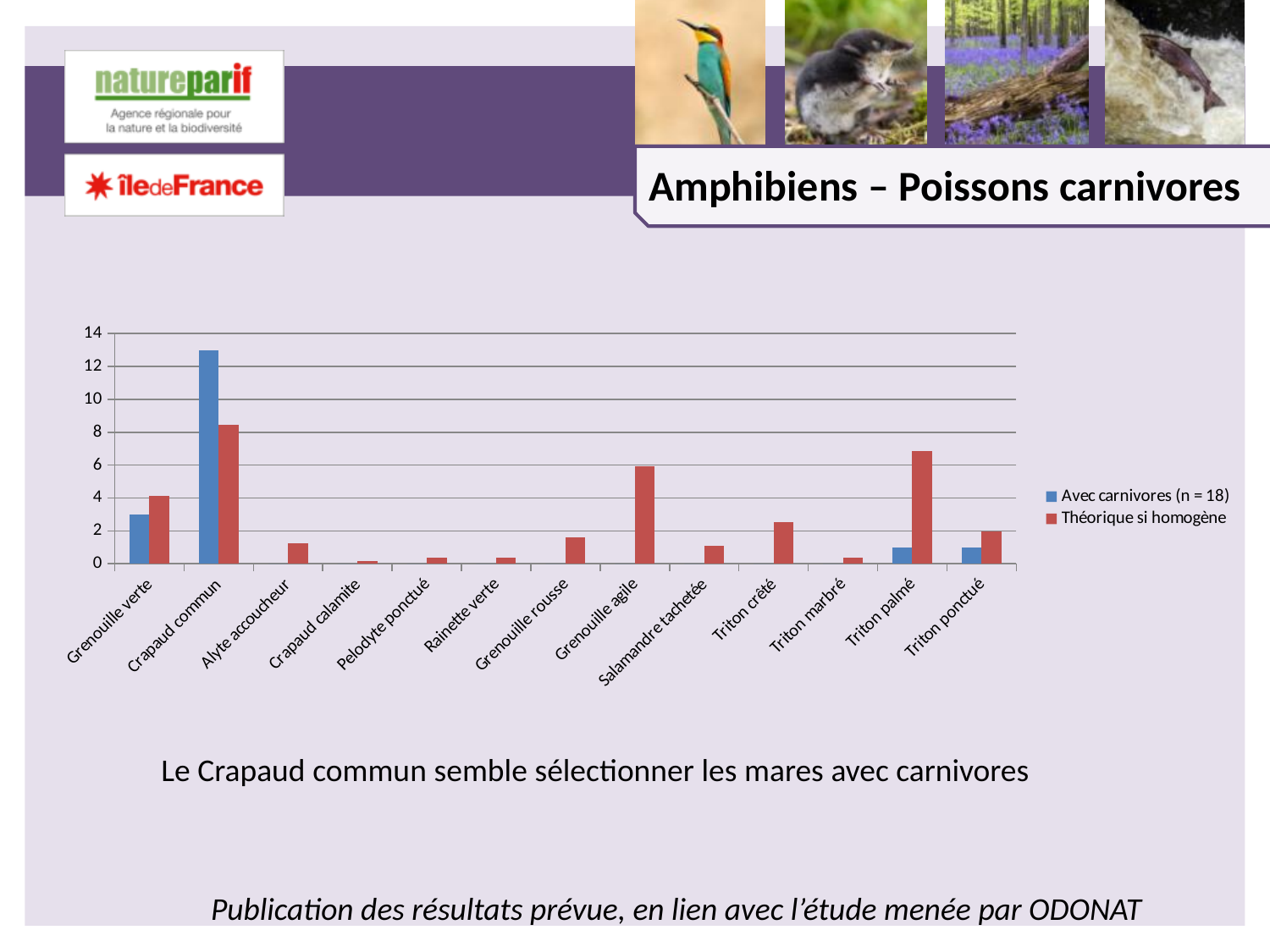
Is the 'Théorique si homogène' value for Grenouille agile greater or less than 4? greater How many series does the legend list? 2 For Crapaud commun, which series has the larger value: 'Avec carnivores (n = 18)' or 'Théorique si homogène'? Avec carnivores (n = 18) What kind of chart is shown on the slide? bar chart What colour are the bars for the 'Théorique si homogène' series? red Is the 'Avec carnivores (n = 18)' value for Crapaud commun greater or less than 12? greater Which species has the highest value for the 'Théorique si homogène' series? Crapaud commun For Triton palmé, which series has the larger value: 'Avec carnivores (n = 18)' or 'Théorique si homogène'? Théorique si homogène Is the 'Théorique si homogène' value for Crapaud commun greater or less than 10? less How many species categories are shown on the x axis? 13 Which species has the highest value for the 'Avec carnivores (n = 18)' series? Crapaud commun